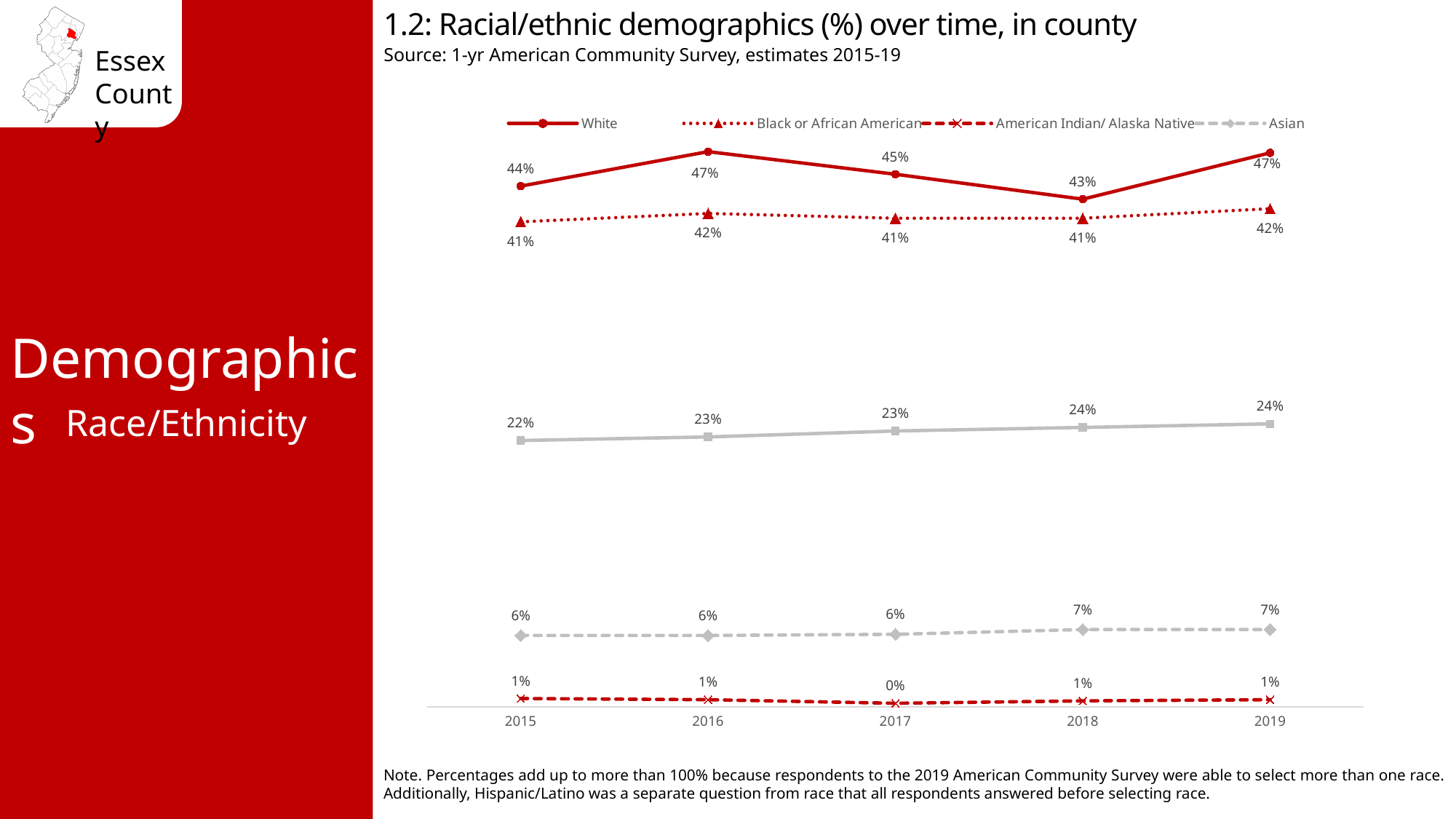
What is the value for Asian in 2019? 7% What is the value for American Indian/ Alaska Native in 2017? 0% What is the difference between the White value in 2016 and in 2018? 4 percentage points What kind of chart is shown on the slide? Line chart In 2017, which is larger: the value for White or for Black or African American? White What is the title of the chart? 1.2: Racial/ethnic demographics (%) over time, in county How many years are shown on the x axis? 5 What is the value for White in 2016? 47% What is the value for White in 2018? 43% Does the value for Asian rise or fall from 2015 to 2019? Rises What is the value for Black or African American in 2015? 41% In which year is the value for White lowest? 2018